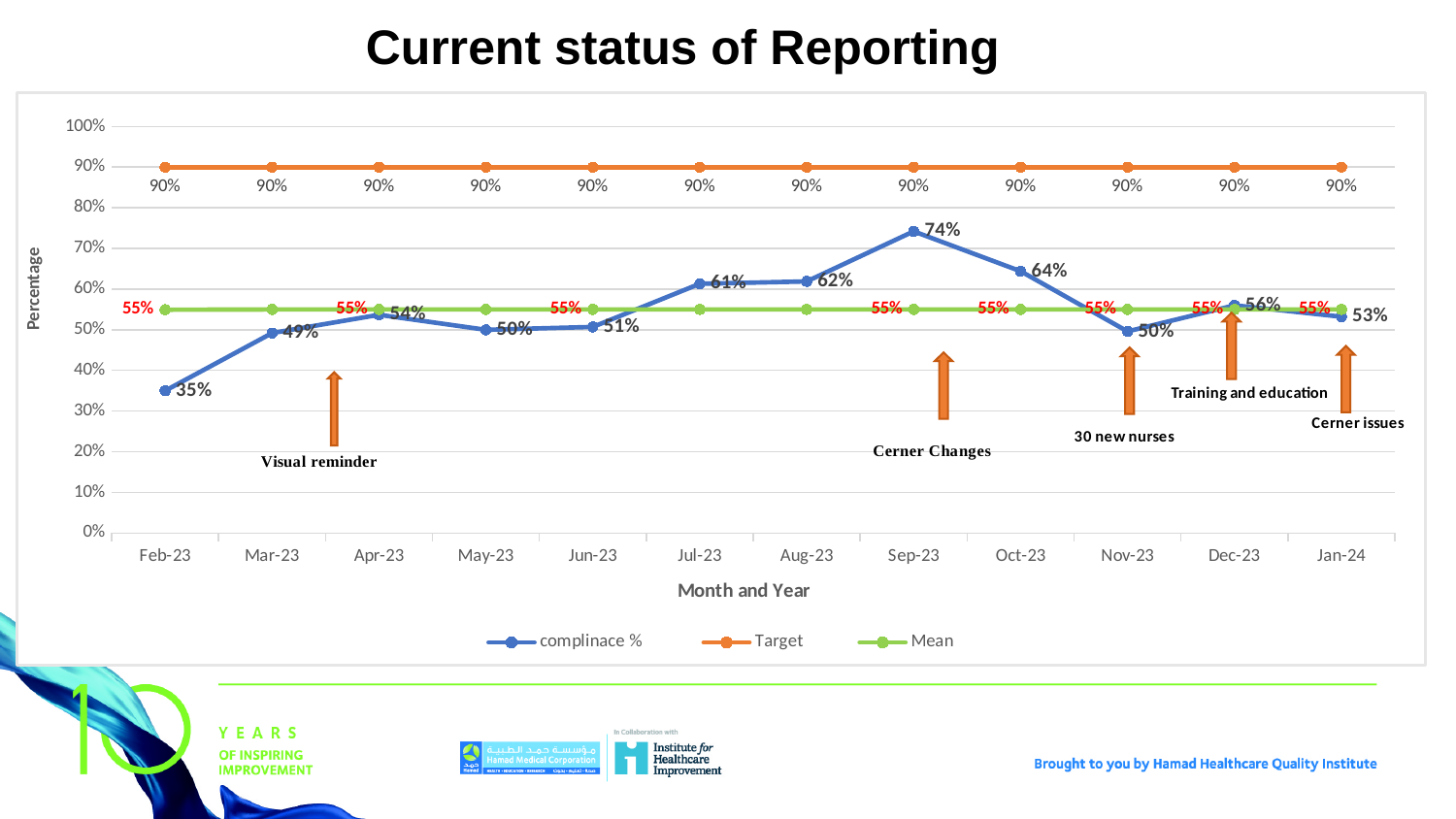
How many months are plotted on the x axis? 12 What is the compliance % value for Sep-23? 74% What is the Target value shown for each month? 90% Which is larger, the compliance % in Jul-23 or in Dec-23? Jul-23 What is the title of the chart? Current status of Reporting What kind of chart is shown on the slide? Line chart In which month is the compliance % lowest? Feb-23 What is the compliance % value for Feb-23? 35% How many series does the legend list? 3 In which month is the compliance % highest? Sep-23 What is the Mean value shown for each month? 55% What is the difference between the compliance % in Sep-23 and in Oct-23? 10%